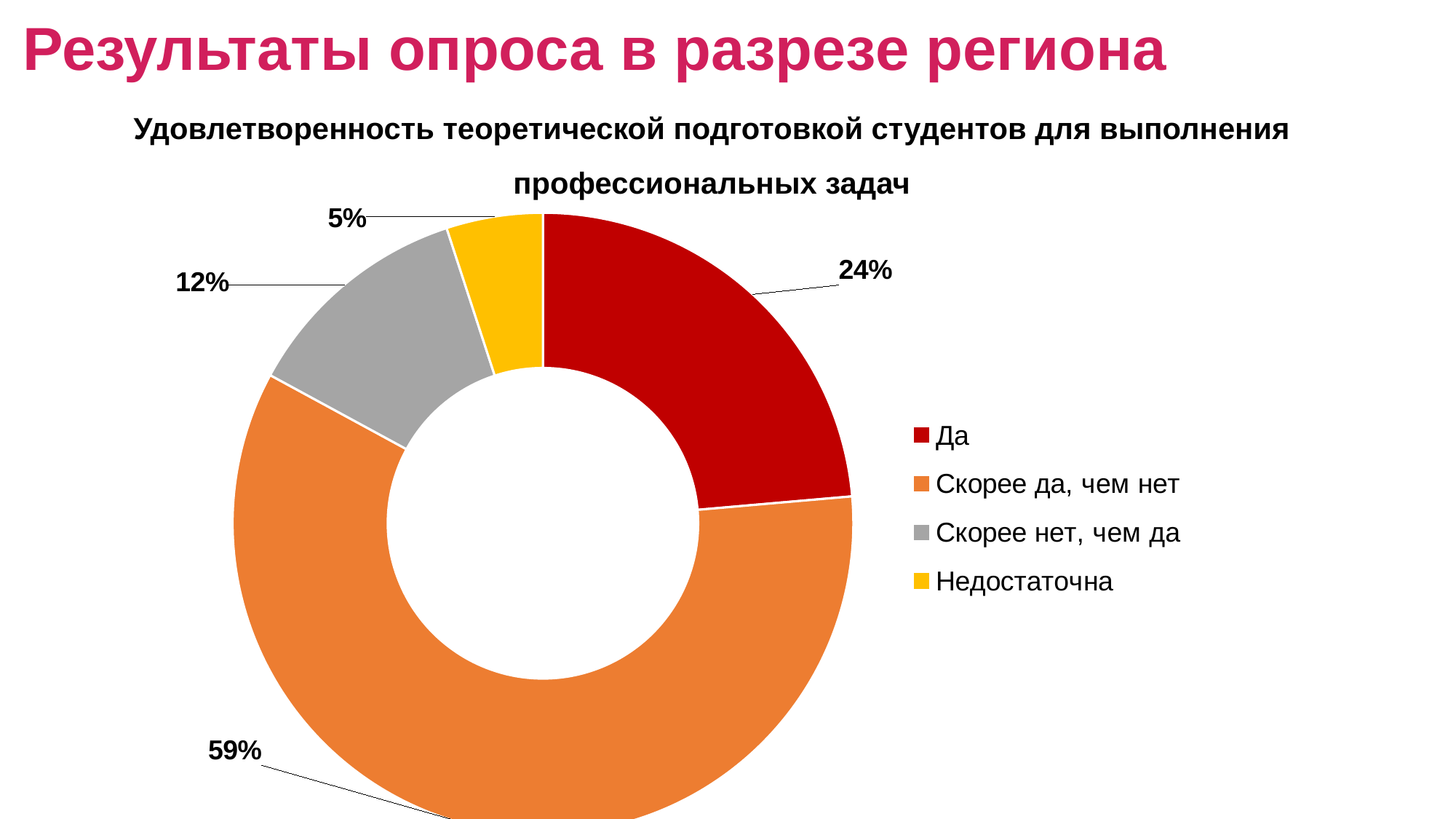
What share of respondents answered "Скорее нет, чем да"? 12% What is the difference in percentage points between "Скорее да, чем нет" and "Да"? 35 Which is larger: the share for "Да" or the share for "Скорее нет, чем да"? Да Which answer option has the smallest share? Недостаточна Which answer option has the largest share? Скорее да, чем нет What share of respondents answered "Скорее да, чем нет"? 59% What share of respondents answered "Да"? 24% What colour represents "Недостаточна" in the chart? Yellow What kind of chart is shown on the slide? Pie (doughnut) chart What is the combined share of "Да" and "Скорее да, чем нет"? 83% What share of respondents answered "Недостаточна"? 5% How many answer options are shown in the chart? 4